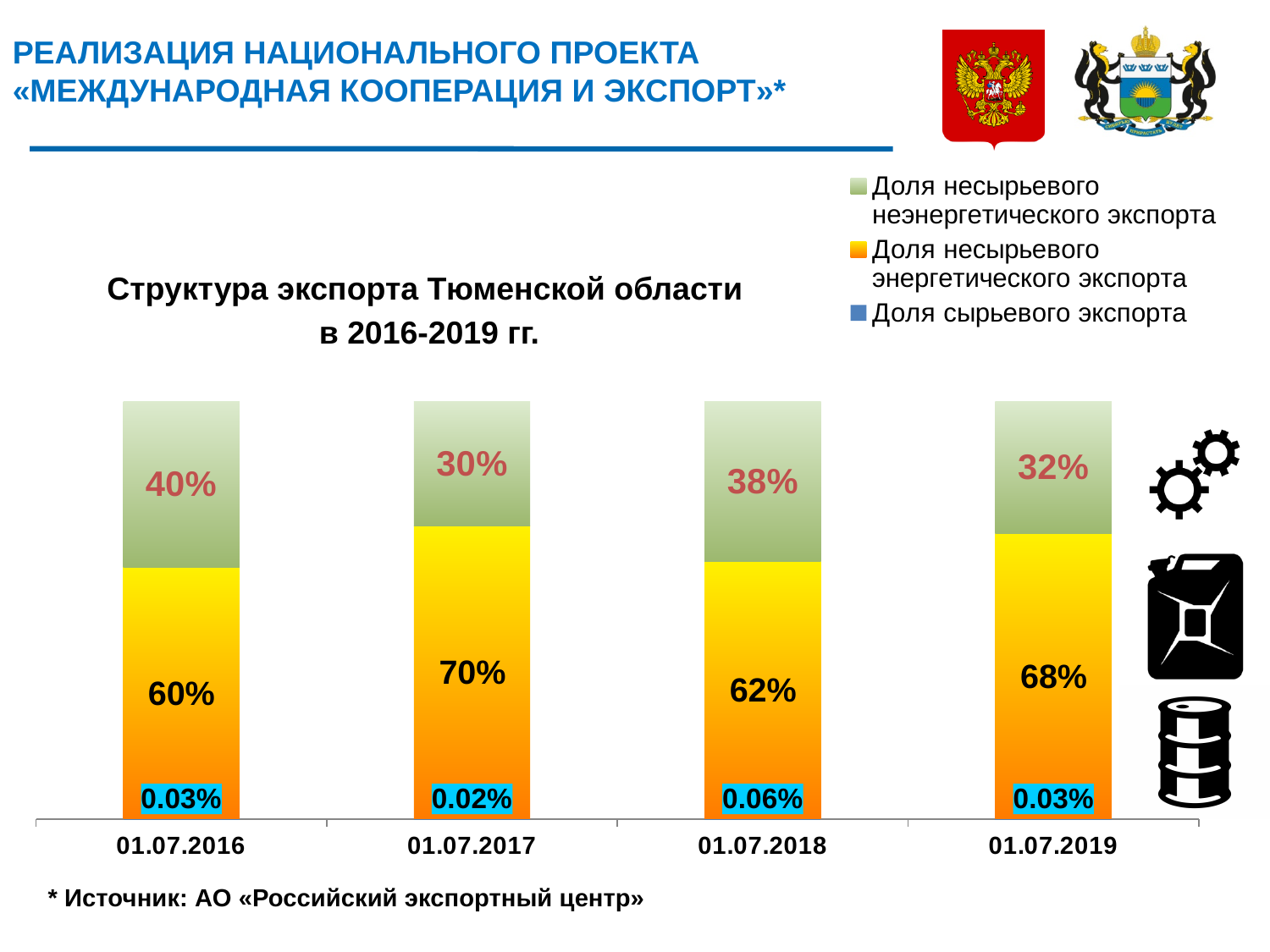
What is the share of raw export (Доля сырьевого экспорта) on 01.07.2018? 0.06% How many series does the legend list? 3 What is the title of the chart? Структура экспорта Тюменской области в 2016-2019 гг. What is the share of non-raw non-energy export (Доля несырьевого неэнергетического экспорта) on 01.07.2018? 38% What is the share of non-raw energy export (Доля несырьевого энергетического экспорта) on 01.07.2017? 70% Does the share of non-raw non-energy export rise or fall from 01.07.2018 to 01.07.2019? fall How many dates (categories) are shown on the x axis? 4 On which date is the share of non-raw non-energy export the highest? 01.07.2016 What type of chart is shown on the slide? stacked bar chart By how many percentage points does the share of non-raw energy export on 01.07.2017 exceed that on 01.07.2016? 10 On which date is the share of non-raw energy export the lowest? 01.07.2016 Which is larger: the share of non-raw non-energy export on 01.07.2017 or on 01.07.2019? 01.07.2019